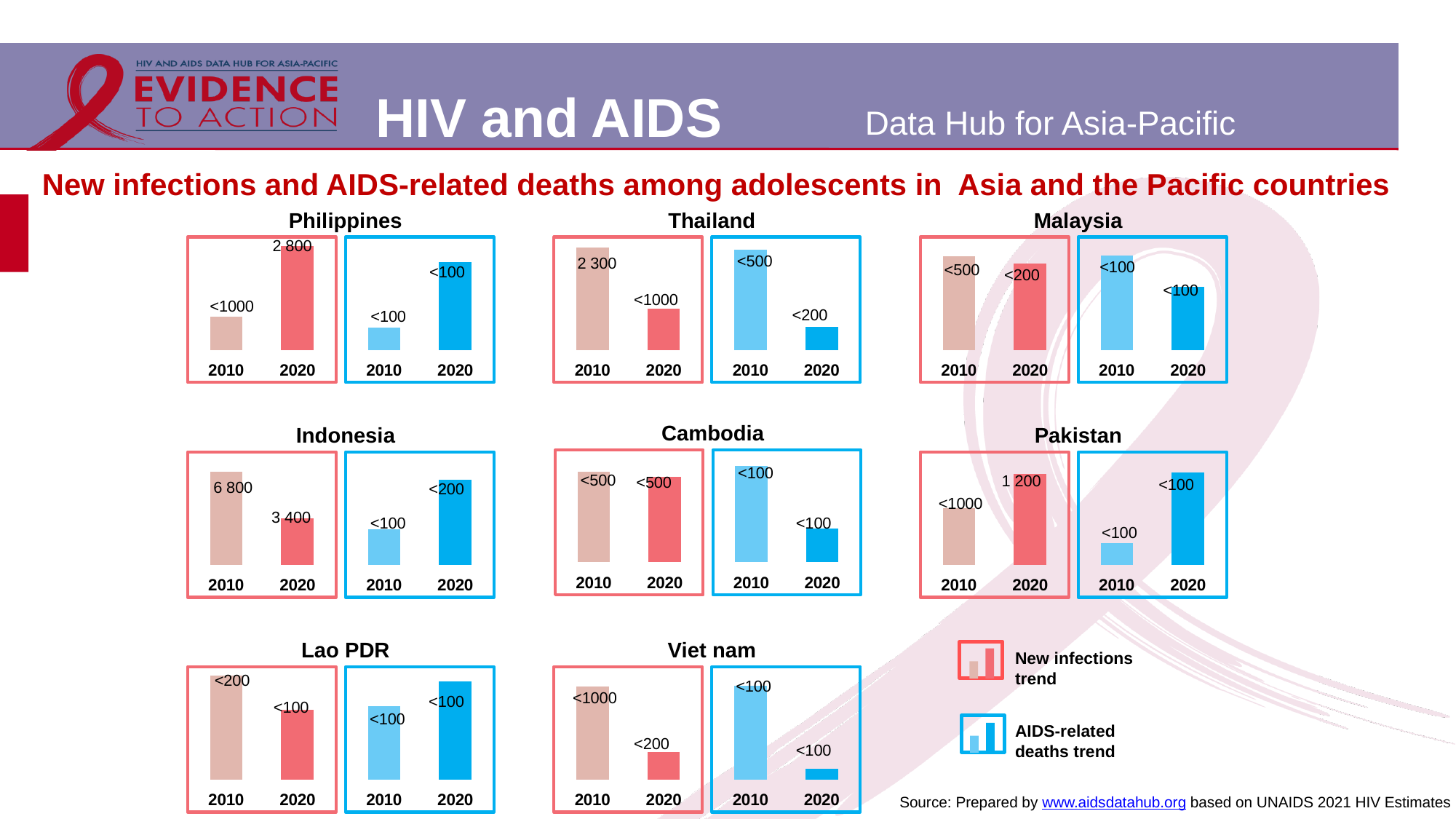
What kind of chart is used for the Viet nam new infections trend? bar chart In the Thailand AIDS-related deaths chart, what is the value label for 2020? <200 In the Philippines new infections chart, what is the value for 2020? 2 800 In the Indonesia new infections chart, what is the value for 2020? 3 400 In the Indonesia new infections chart, what is the difference between the 2010 and 2020 values? 3 400 In the Indonesia new infections chart, do the values rise or fall from 2010 to 2020? fall In the Philippines new infections chart, which year has the higher value, 2010 or 2020? 2020 In the Thailand AIDS-related deaths chart, do the values rise or fall from 2010 to 2020? fall How many trend series does the legend on the slide list? 2 In the Thailand new infections chart, what is the value for 2010? 2 300 In the Indonesia new infections chart, what is the value for 2010? 6 800 In the Pakistan new infections chart, what is the value for 2020? 1 200